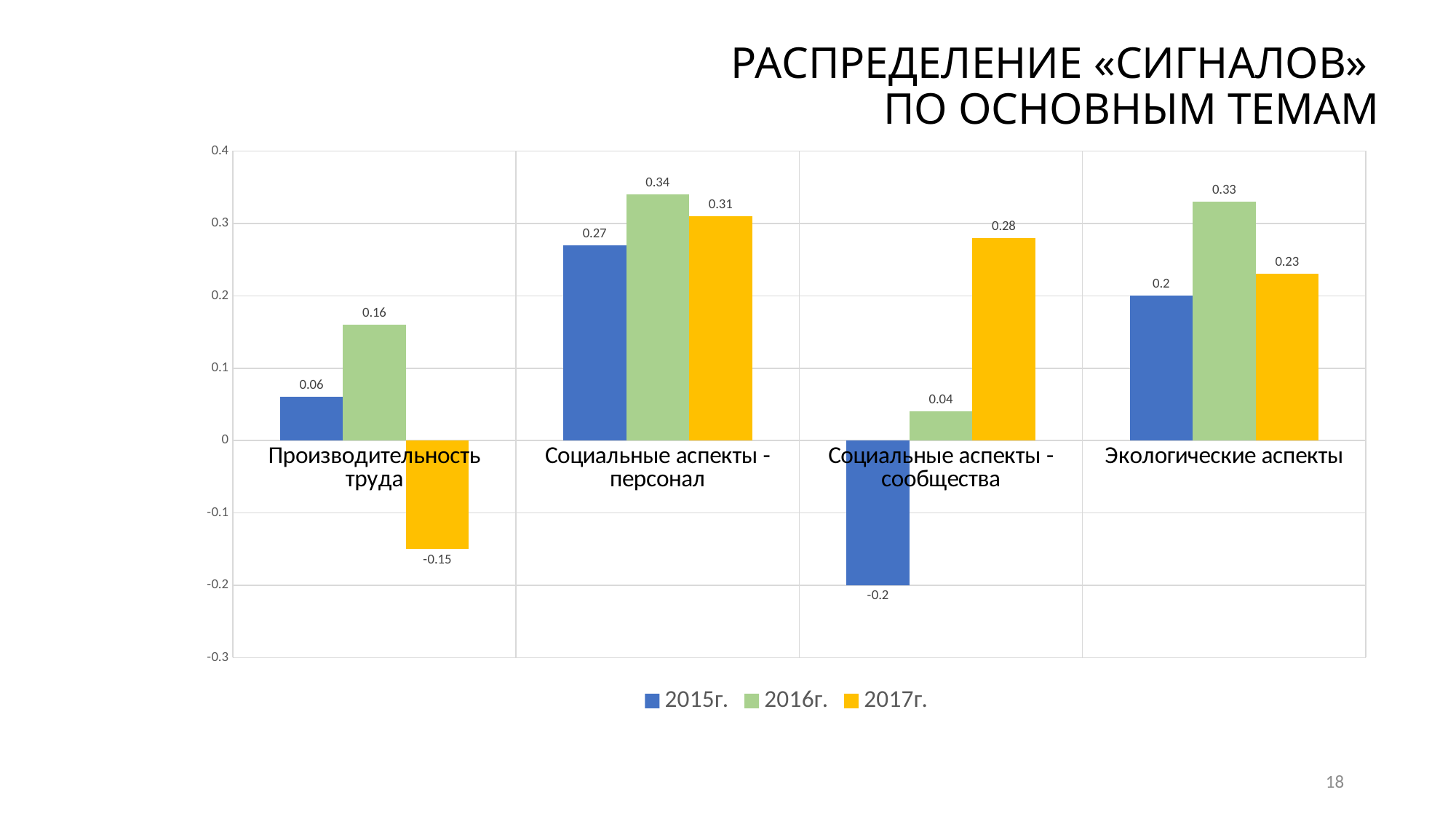
Which category has the lowest value for the 2016г. series? Социальные аспекты - сообщества What is the value for 2016г. in the category Социальные аспекты - персонал? 0.34 Which is larger in the category Социальные аспекты - персонал: the value for 2017г. or the value for 2015г.? 2017г. Which colour represents the 2017г. series in the chart? Yellow What is the value for 2017г. in the category Экологические аспекты? 0.23 What is the value for 2015г. in the category Социальные аспекты - сообщества? -0.2 What kind of chart is shown on the slide? Bar chart Which category has the highest value for the 2015г. series? Социальные аспекты - персонал How many series does the legend list? 3 How many categories are shown on the x axis of the chart? 4 What is the difference between the 2016г. and 2015г. values in the category Экологические аспекты? 0.13 What is the value for 2017г. in the category Производительность труда? -0.15